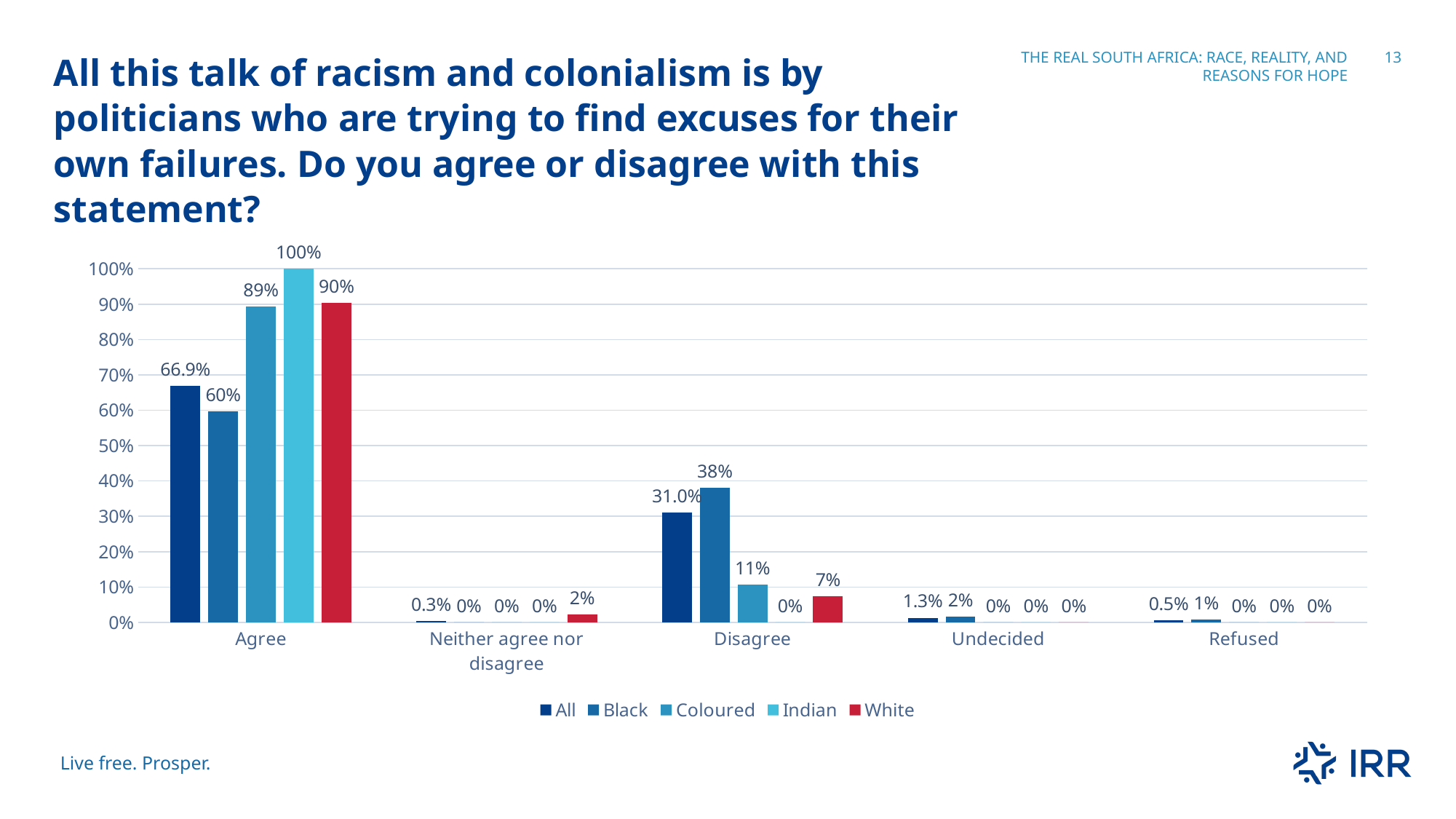
Is the Agree value for Coloured respondents larger than the Agree value for White respondents? No Which colour represents the White series in the chart? Red How many response categories are shown on the x axis? 5 What percentage of Indian respondents agree with the statement? 100% Which series has the highest value in the Agree category? Indian What percentage of White respondents disagree with the statement? 7% How many series does the legend list? 5 What is the value for Black respondents in the Undecided category? 2% What is the value for the All series in the Disagree category? 31.0% What kind of chart is shown on the slide? Bar chart Which series has the lowest value in the Agree category? Black What is the difference between the Coloured and Black values in the Disagree category? 27 percentage points